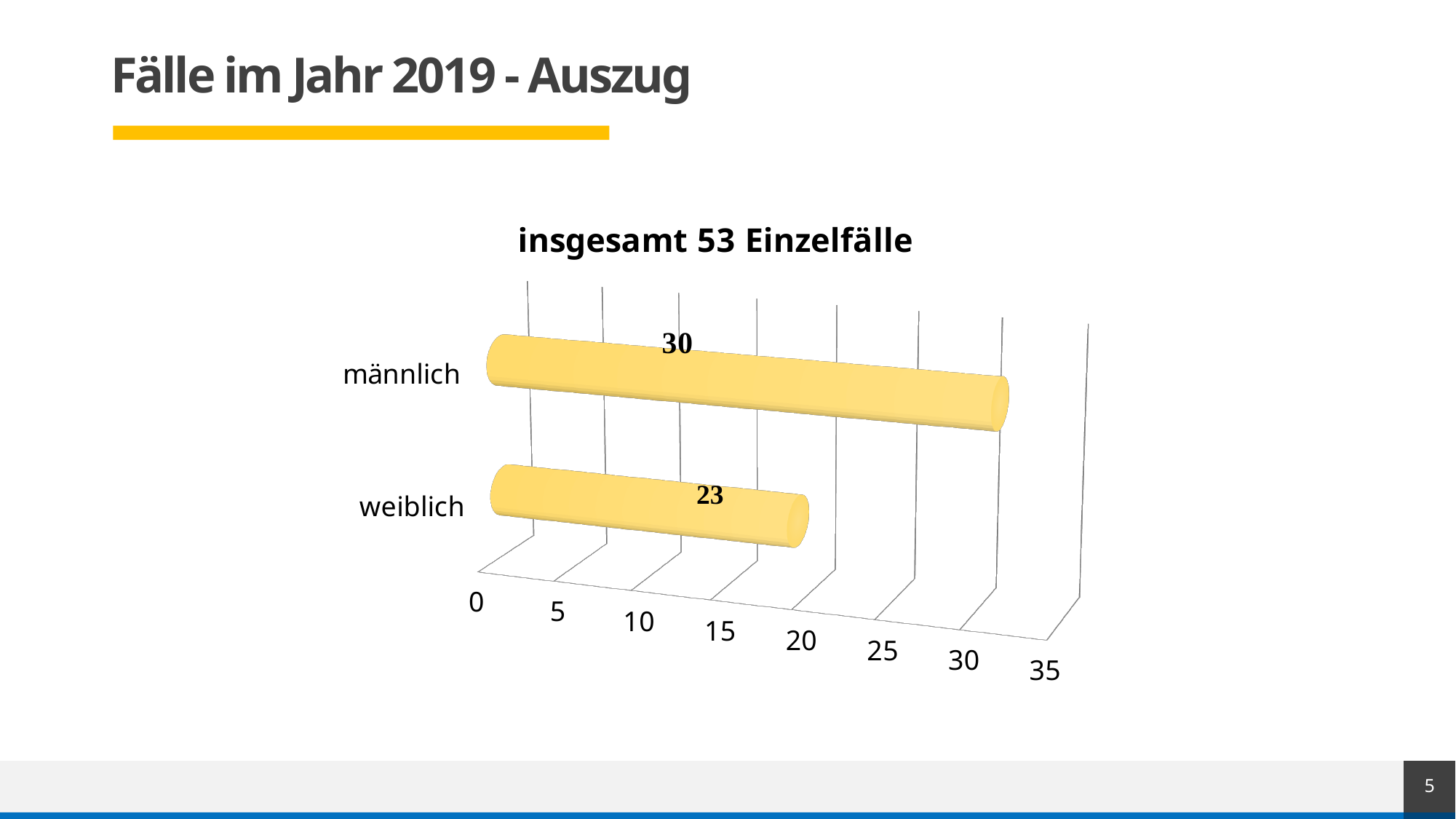
Which is larger, the value for männlich or the value for weiblich? männlich What is the value for männlich? 30 What is the value for weiblich? 23 Is the value for männlich greater or less than 25? greater Which category has the highest value? männlich How many categories are shown in the chart? 2 Is the value for weiblich greater or less than 25? less What is the title of the chart? insgesamt 53 Einzelfälle What is the difference between the values for männlich and weiblich? 7 Which category has the lowest value? weiblich What is the highest value shown on the value axis? 35 What kind of chart is shown on the slide? bar chart